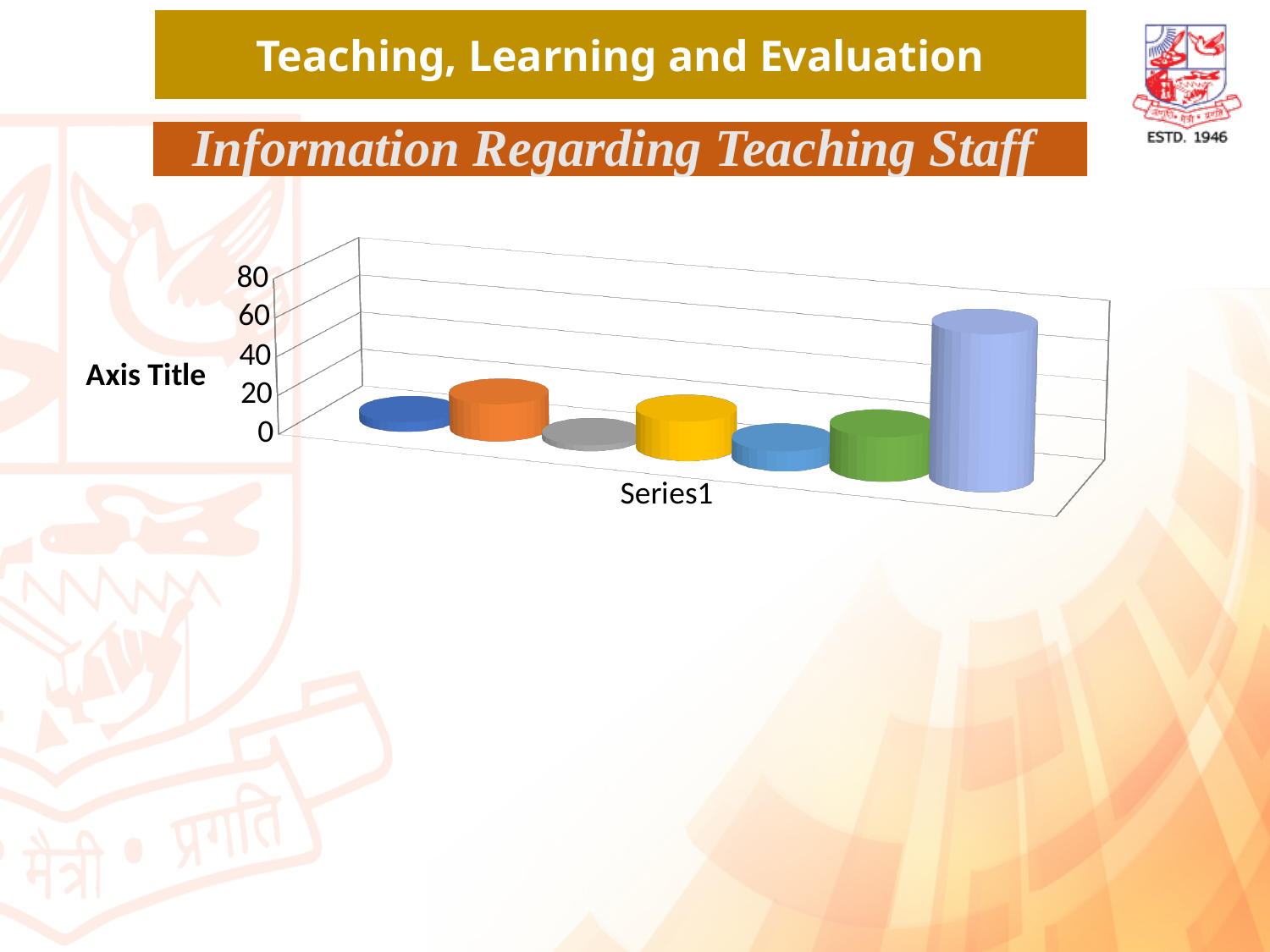
Is the value of the first (dark blue) bar greater or less than 40? less How many bars are plotted in the chart? 7 Which is larger, the orange bar or the gray bar? the orange bar Which bar is the shortest in the chart? the gray bar (third from left) What kind of chart is shown on the slide? bar chart Which bar is the tallest in the chart? the light blue bar on the far right What is the highest tick value shown on the vertical axis? 80 Which is larger, the far right light blue bar or the green bar? the far right light blue bar Is the value of the tallest (far right, light blue) bar greater or less than 40? greater Is the value of the gray bar greater or less than 20? less What label appears below the bars on the horizontal axis? Series1